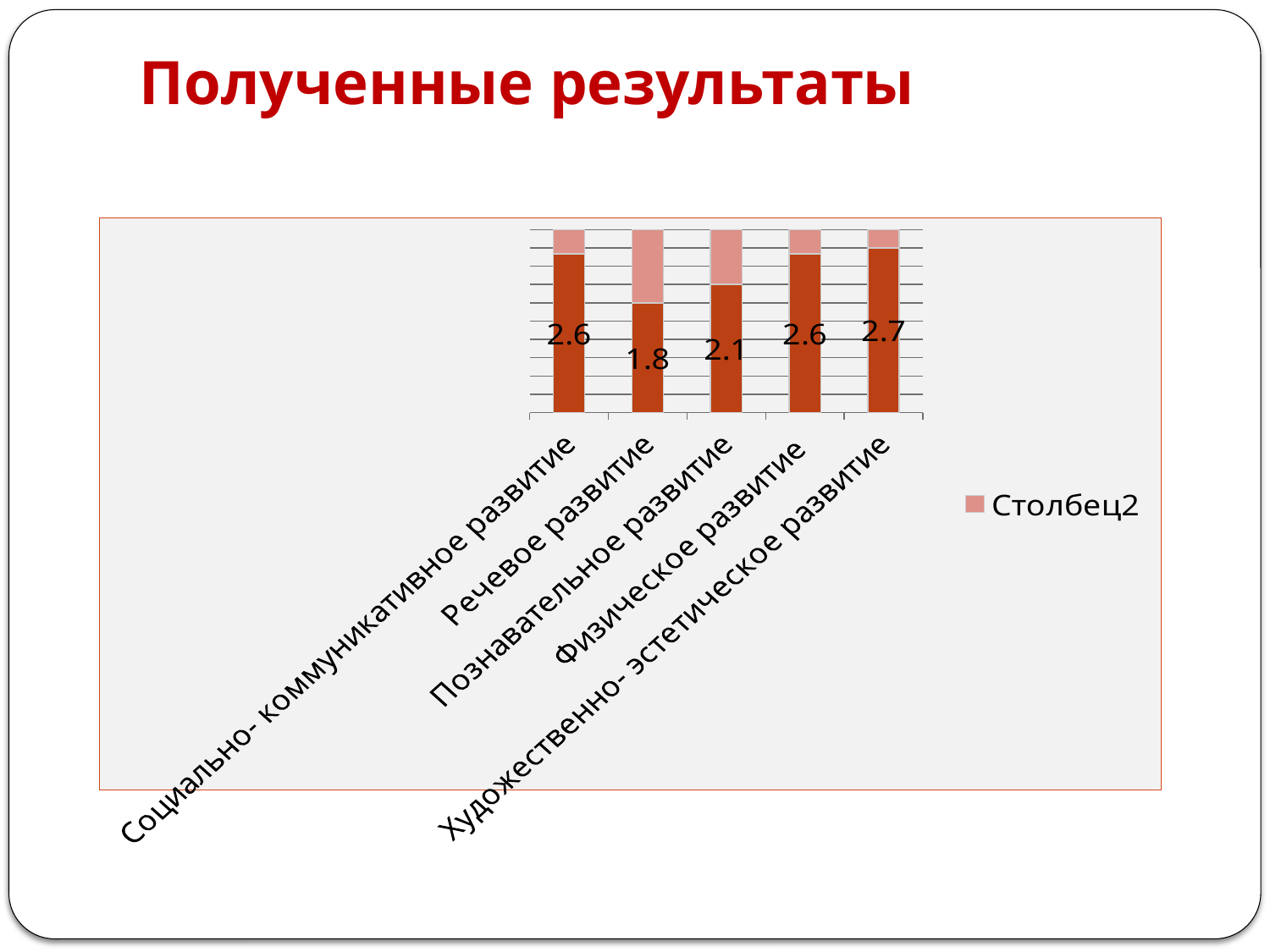
What is the difference between the labelled values for Социально- коммуникативное развитие and Познавательное развитие? 0.5 What is the labelled value for Художественно- эстетическое развитие? 2.7 What is the labelled value for Познавательное развитие? 2.1 Which has the larger labelled value, Речевое развитие or Познавательное развитие? Познавательное развитие What is the title of the slide? Полученные результаты Which category has the lowest labelled value? Речевое развитие What is the difference between the labelled values for Художественно- эстетическое развитие and Речевое развитие? 0.9 Which category has the highest labelled value? Художественно- эстетическое развитие What is the labelled value for Физическое развитие? 2.6 How many categories are shown on the x axis? 5 What kind of chart is shown on the slide? Bar chart What is the labelled value for Речевое развитие? 1.8